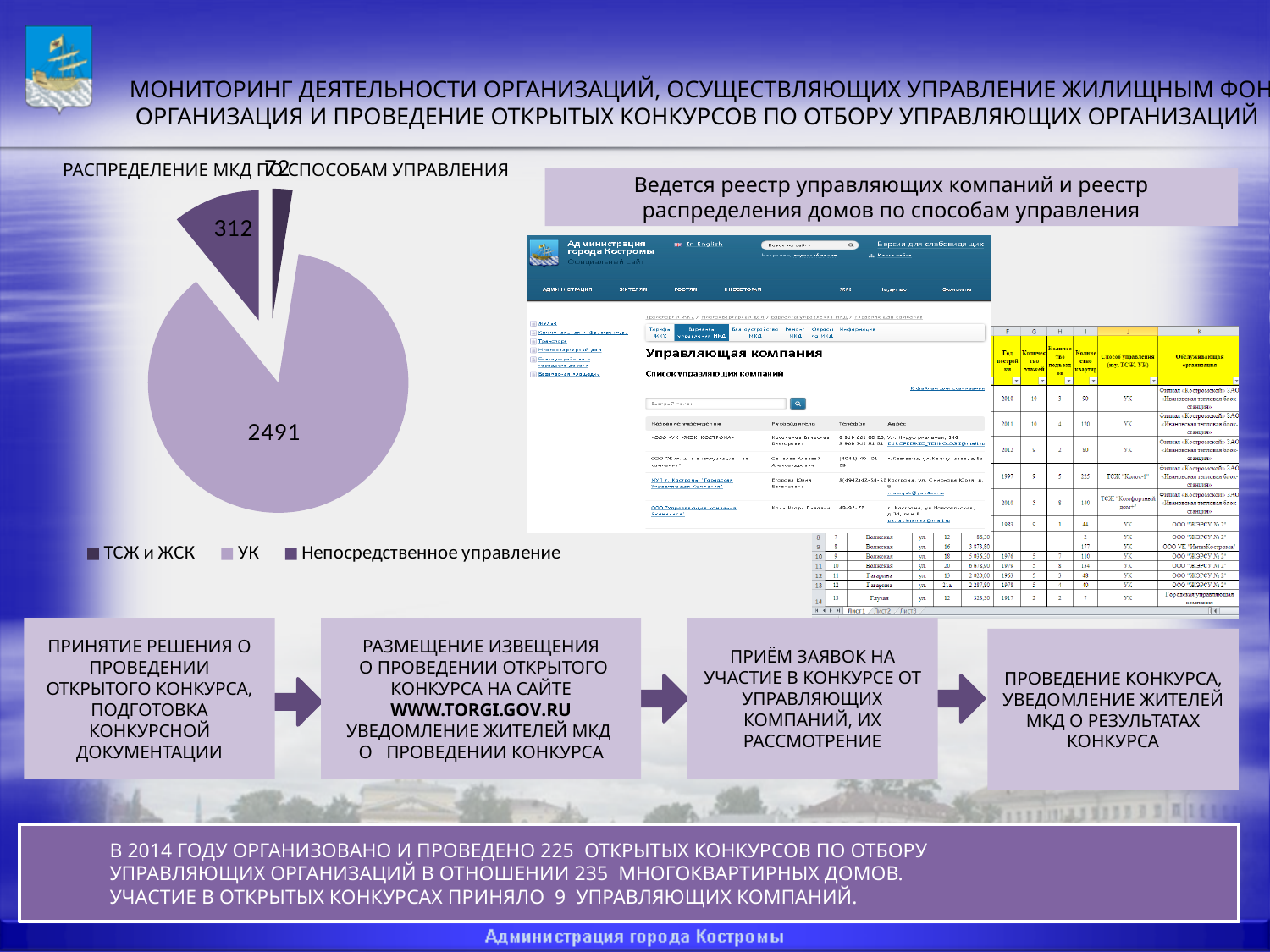
What is the difference between the largest labelled value (2491) and the value 312 in the pie chart? 2179 What is the smallest value labelled on the pie chart? 72 How many entries does the pie chart legend list? 3 What is the value for УК in the pie chart? 2491 What is the largest value labelled on the pie chart? 2491 Which legend entry is listed first under the pie chart? ТСЖ и ЖСК Which category has the largest slice in the pie chart? УК How many slices does the pie chart have? 3 Which is larger in the pie chart: the value 312 or the value 72? 312 What kind of chart is shown on the slide? pie chart What is the title of the pie chart? РАСПРЕДЕЛЕНИЕ МКД ПО СПОСОБАМ УПРАВЛЕНИЯ What is the total of all three values labelled on the pie chart? 2875